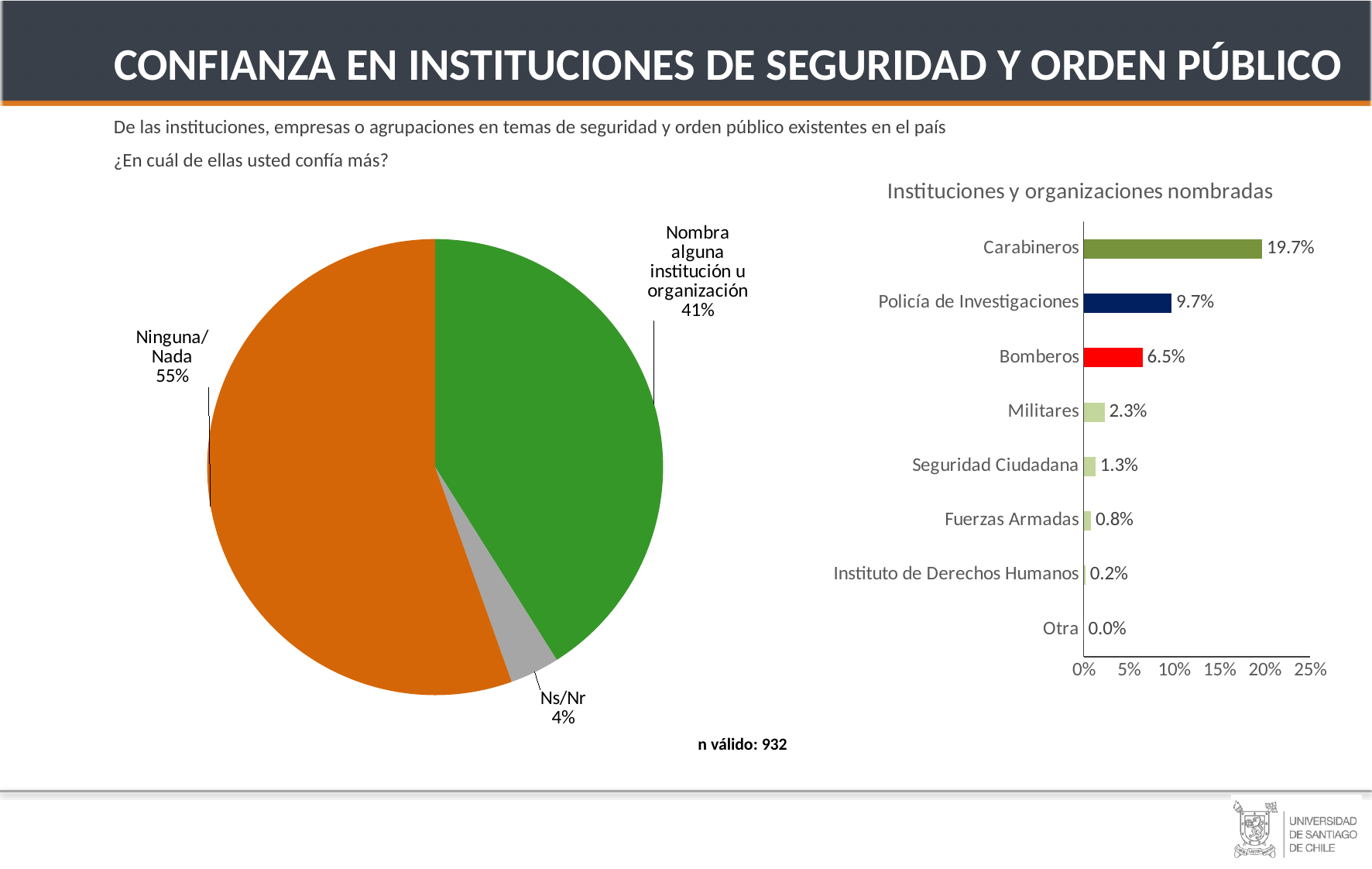
In the pie chart on the left, what share is labelled for Ninguna/Nada? 55% In the chart titled 'Instituciones y organizaciones nombradas', which is larger, Militares or Seguridad Ciudadana? Militares In the chart titled 'Instituciones y organizaciones nombradas', what is the difference between Carabineros and Policía de Investigaciones? 10.0% In the pie chart on the left, what is the difference between the Ninguna/Nada share and the 'Nombra alguna institución u organización' share? 14% In the pie chart on the left, what share is labelled for Ns/Nr? 4% What kind of chart is the one titled 'Instituciones y organizaciones nombradas'? Bar chart In the chart titled 'Instituciones y organizaciones nombradas', what is the value for Bomberos? 6.5% In the chart titled 'Instituciones y organizaciones nombradas', how many categories are shown? 8 In the pie chart on the left, which slice is the largest? Ninguna/Nada In the pie chart on the left, how many slices are there? 3 In the chart titled 'Instituciones y organizaciones nombradas', what is the value for Carabineros? 19.7% In the chart titled 'Instituciones y organizaciones nombradas', which category has the lowest value? Otra